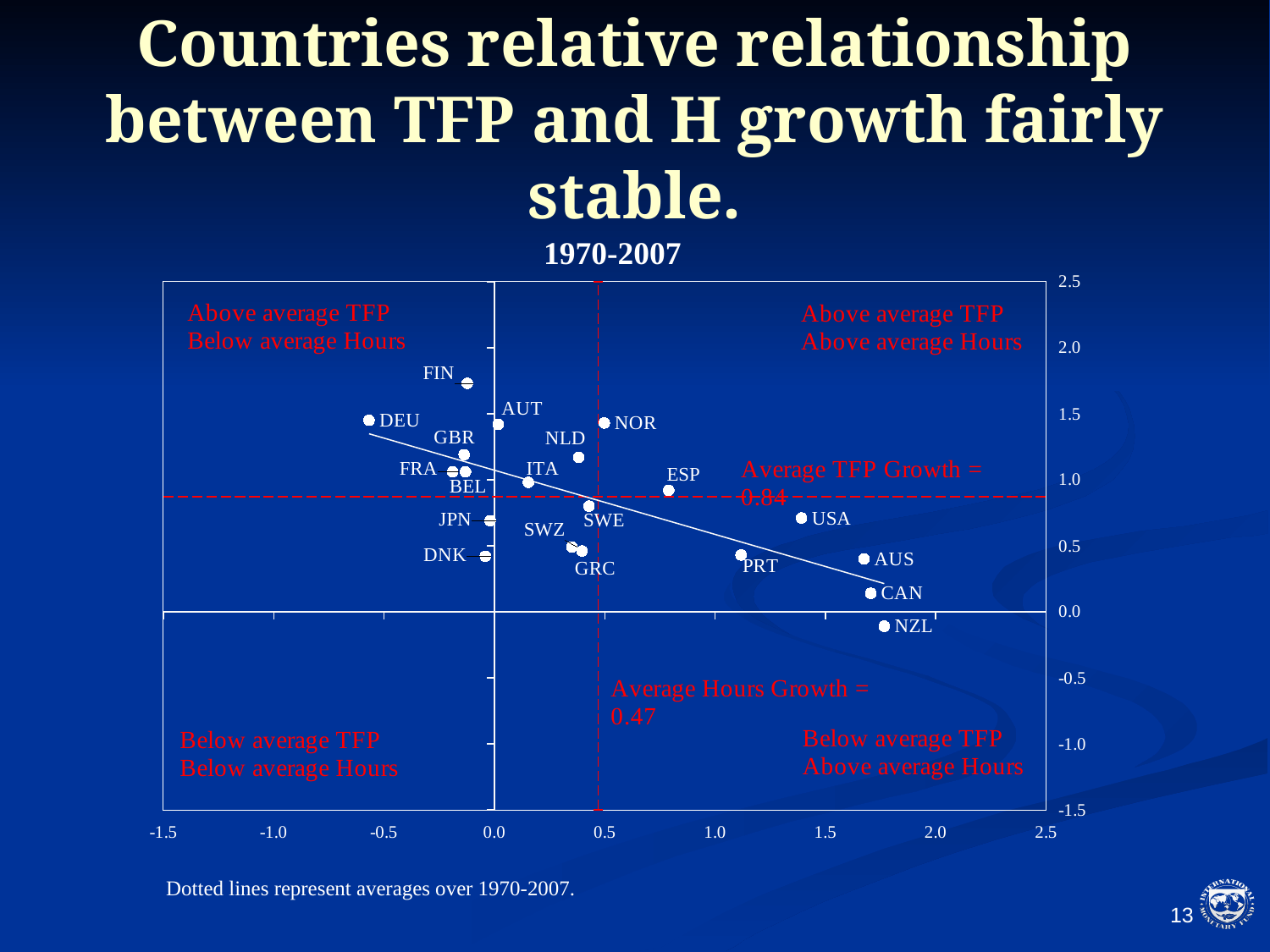
Is the vertical-axis value for NZL greater or less than 0.0? less What is the Average TFP Growth value printed on the chart? 0.84 Does the fitted line through the points slope upward or downward as the horizontal-axis value increases? downward Is the vertical-axis value for FIN greater or less than 1.5? greater What kind of chart is shown on the slide? scatter chart What is the title printed directly above the chart? 1970-2007 Which country has the lowest TFP growth (vertical axis) in the chart? NZL Which country has the lowest hours growth (horizontal axis) in the chart? DEU Is the horizontal-axis value for USA greater or less than 1.0? greater Which country has the highest TFP growth (vertical axis) in the chart? FIN Which country has the higher vertical-axis value, FIN or DNK? FIN What is the Average Hours Growth value printed on the chart? 0.47